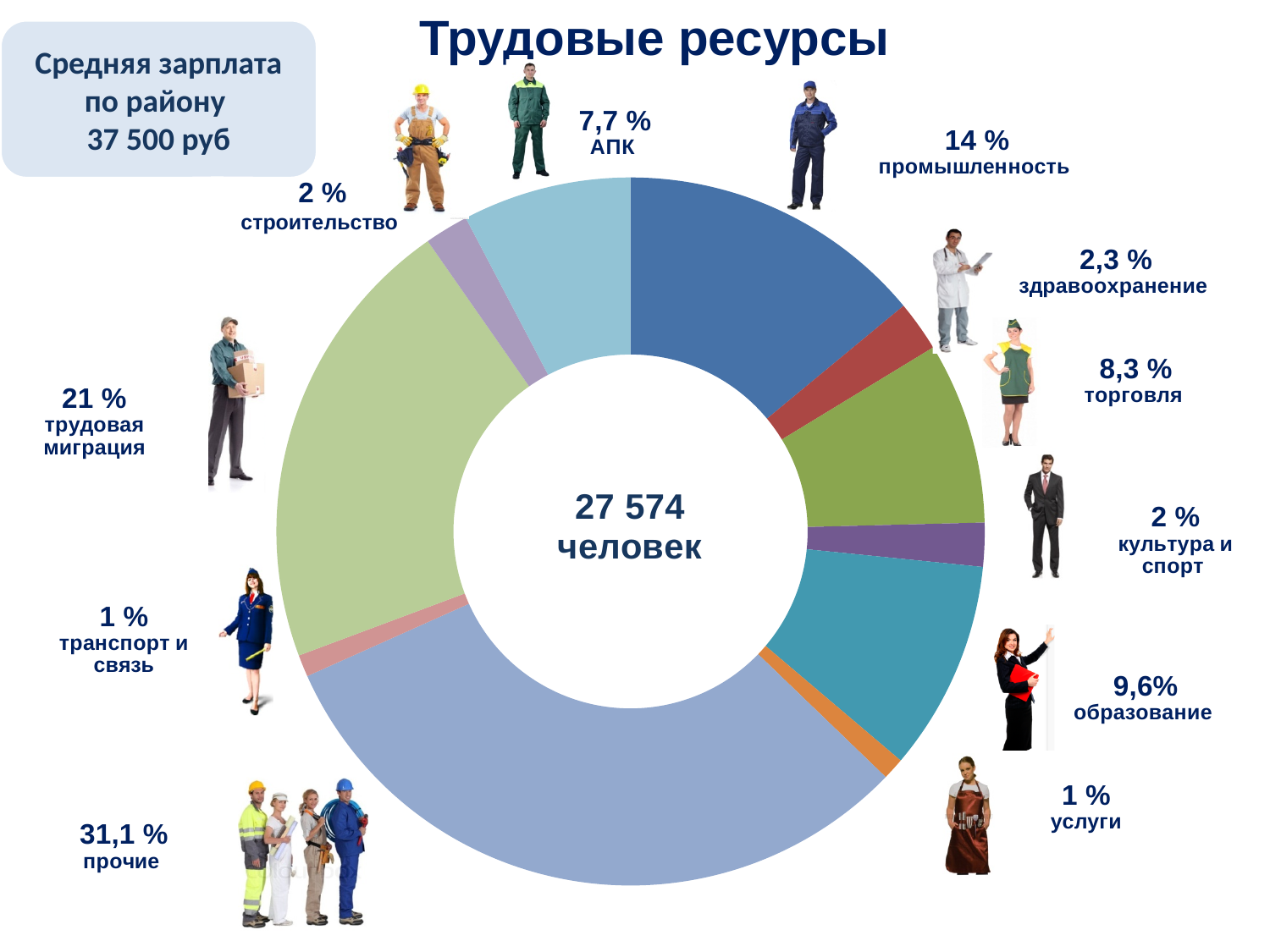
What share of the labour resources is трудовая миграция? 21 % What total number of people is shown in the centre of the chart? 27 574 человек What is the difference in percentage points between промышленность and образование? 4,4 What is the difference in percentage points between прочие and трудовая миграция? 10,1 What share of the labour resources is промышленность? 14 % How many categories are shown in the chart? 11 What share of the labour resources is образование? 9,6% Which category has the larger share: торговля or АПК? торговля Which category has the largest share of the labour resources? прочие What share of the labour resources is здравоохранение? 2,3 % What is the title of the chart? Трудовые ресурсы What kind of chart is shown on the slide? pie chart (donut)